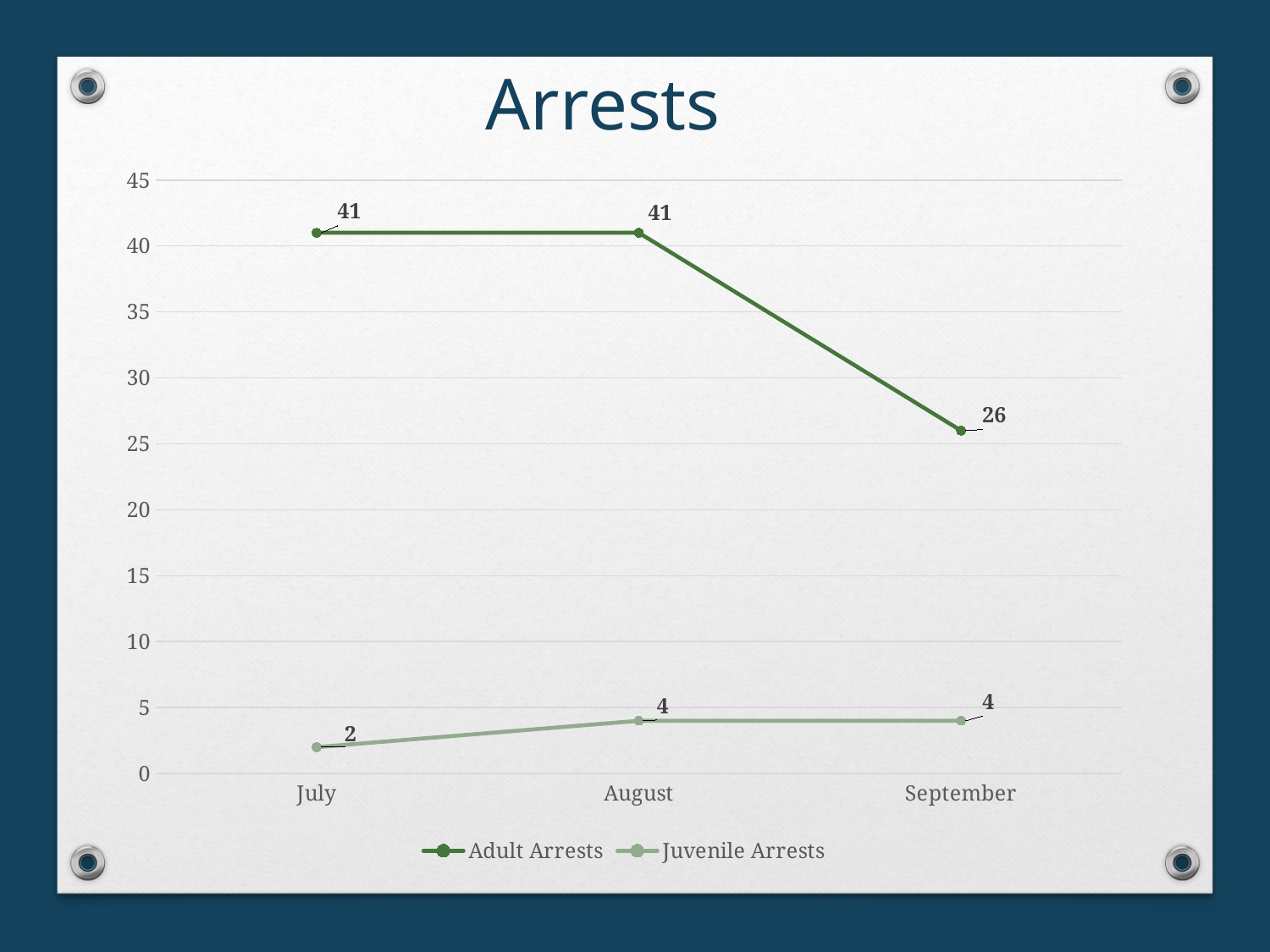
In which month is the Juvenile Arrests value lowest? July How many months are shown on the x axis? 3 What is the value for Adult Arrests in September? 26 What is the value for Juvenile Arrests in July? 2 What is the difference between Adult Arrests in August and September? 15 Which is larger in September: Adult Arrests or Juvenile Arrests? Adult Arrests In which month is the Adult Arrests value lowest? September Does the Adult Arrests line rise or fall from August to September? Fall What kind of chart is shown on the slide? Line chart How many series does the legend list? 2 What is the difference between Adult Arrests and Juvenile Arrests in July? 39 What is the value for Adult Arrests in August? 41